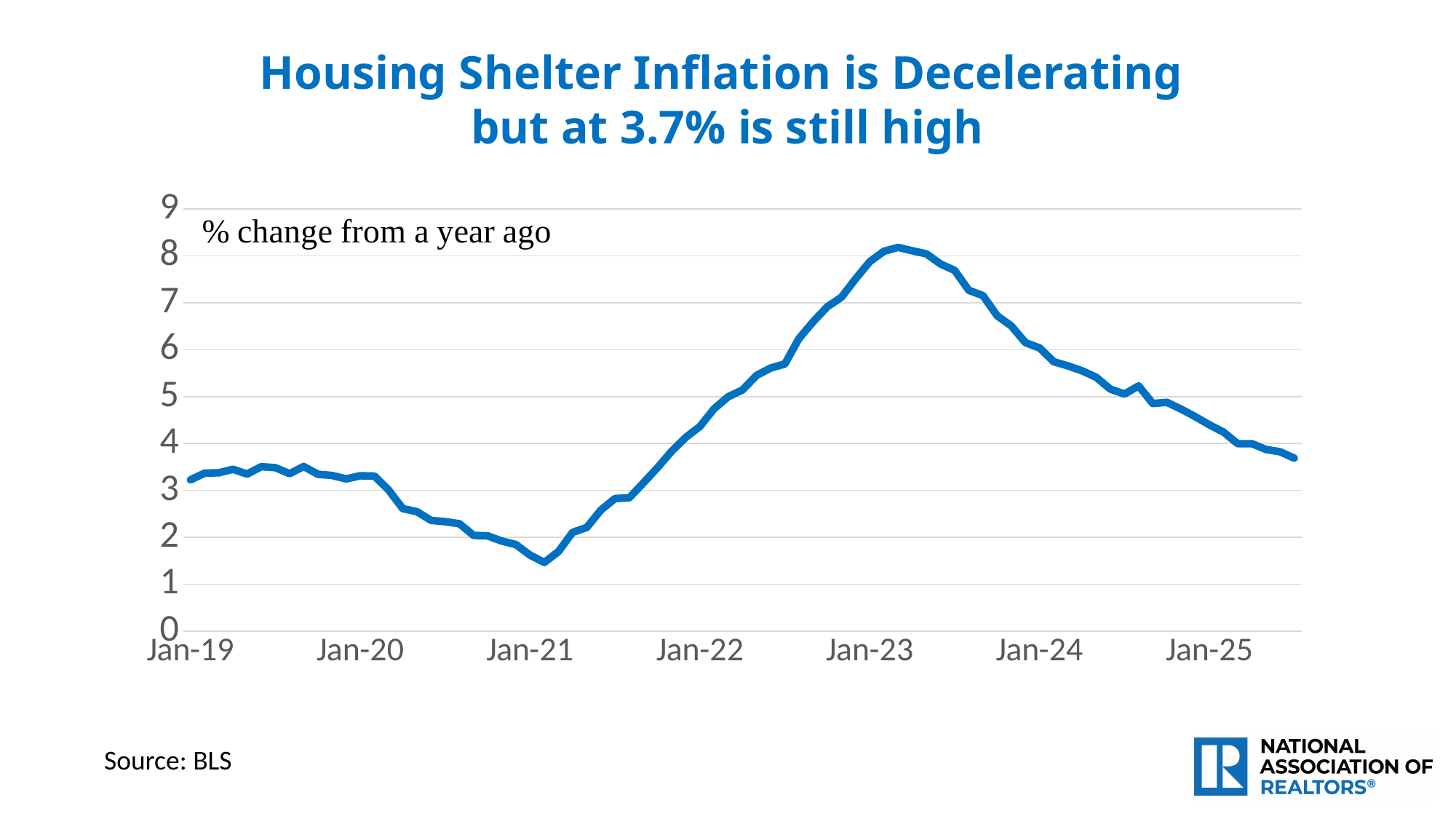
Is the value at Jan-25 greater or less than 4? greater Does the line rise or fall between Jan-23 and Jan-25? fall Around which year label does the line reach its lowest point? Jan-21 Around which year label does the line reach its highest point? Jan-23 Is the value at Jan-23 greater or less than 7? greater What is the title of the chart? Housing Shelter Inflation is Decelerating but at 3.7% is still high Is the value at Jan-19 greater or less than 3? greater What kind of chart is shown on the slide? line chart According to the slide, what is the latest housing shelter inflation rate? 3.7% Which is larger, the value at Jan-23 or the value at Jan-21? Jan-23 What does the text label inside the chart say the values represent? % change from a year ago